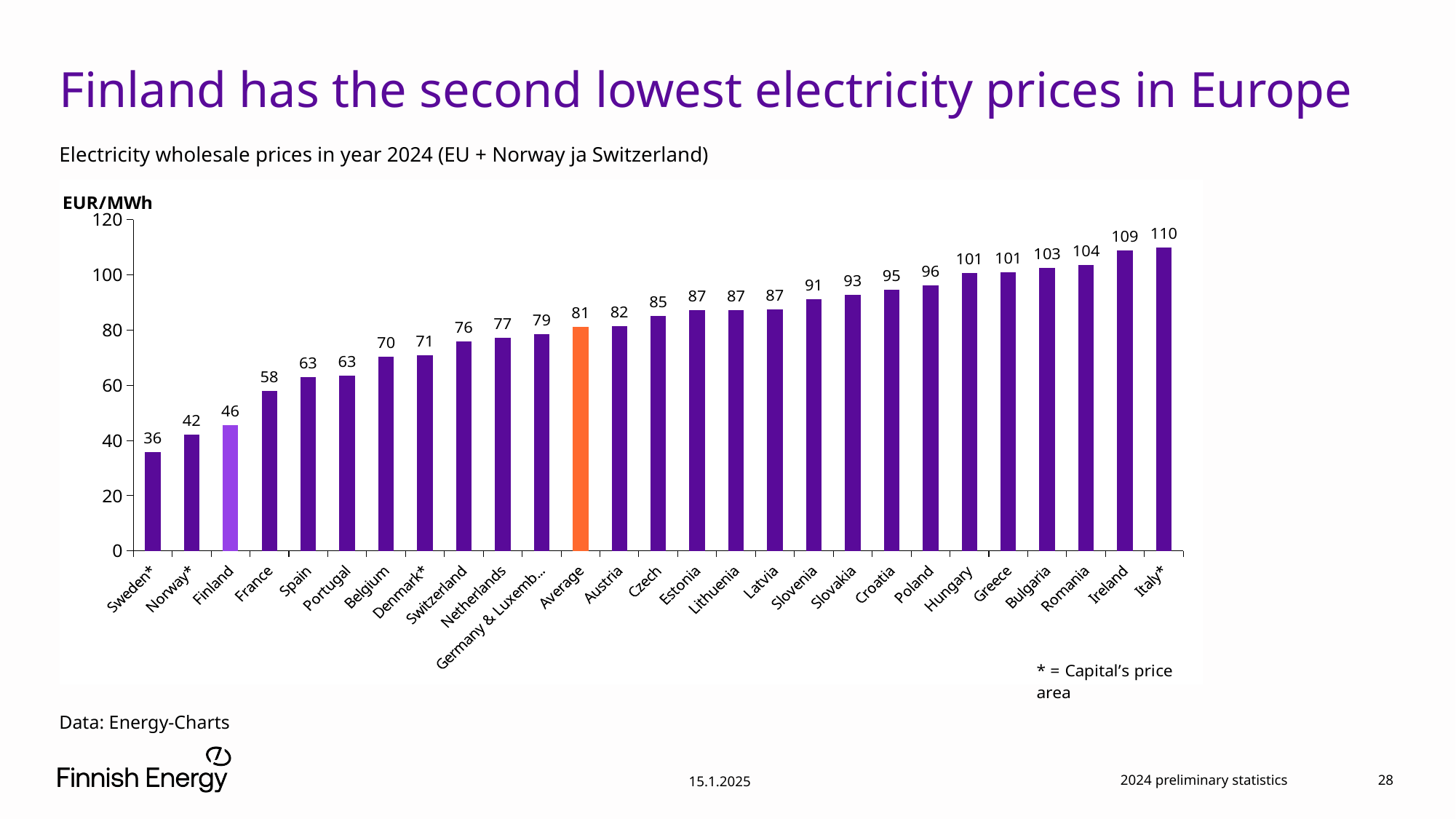
Which category has the lowest electricity wholesale price? Sweden* How many bars are shown in the chart? 27 What is the value shown for the Average bar? 81 Which category has the highest electricity wholesale price? Italy* Do the values rise or fall from left to right along the x axis? Rise What kind of chart is shown on the slide? Bar chart What is the difference between the Average value and the value for Finland? 35 What unit is shown on the y axis of the chart? EUR/MWh What is the difference between the values for Italy* and Sweden*? 74 What is the electricity wholesale price for Finland? 46 Which has a higher electricity wholesale price, France or Belgium? Belgium What is the electricity wholesale price for Poland? 96